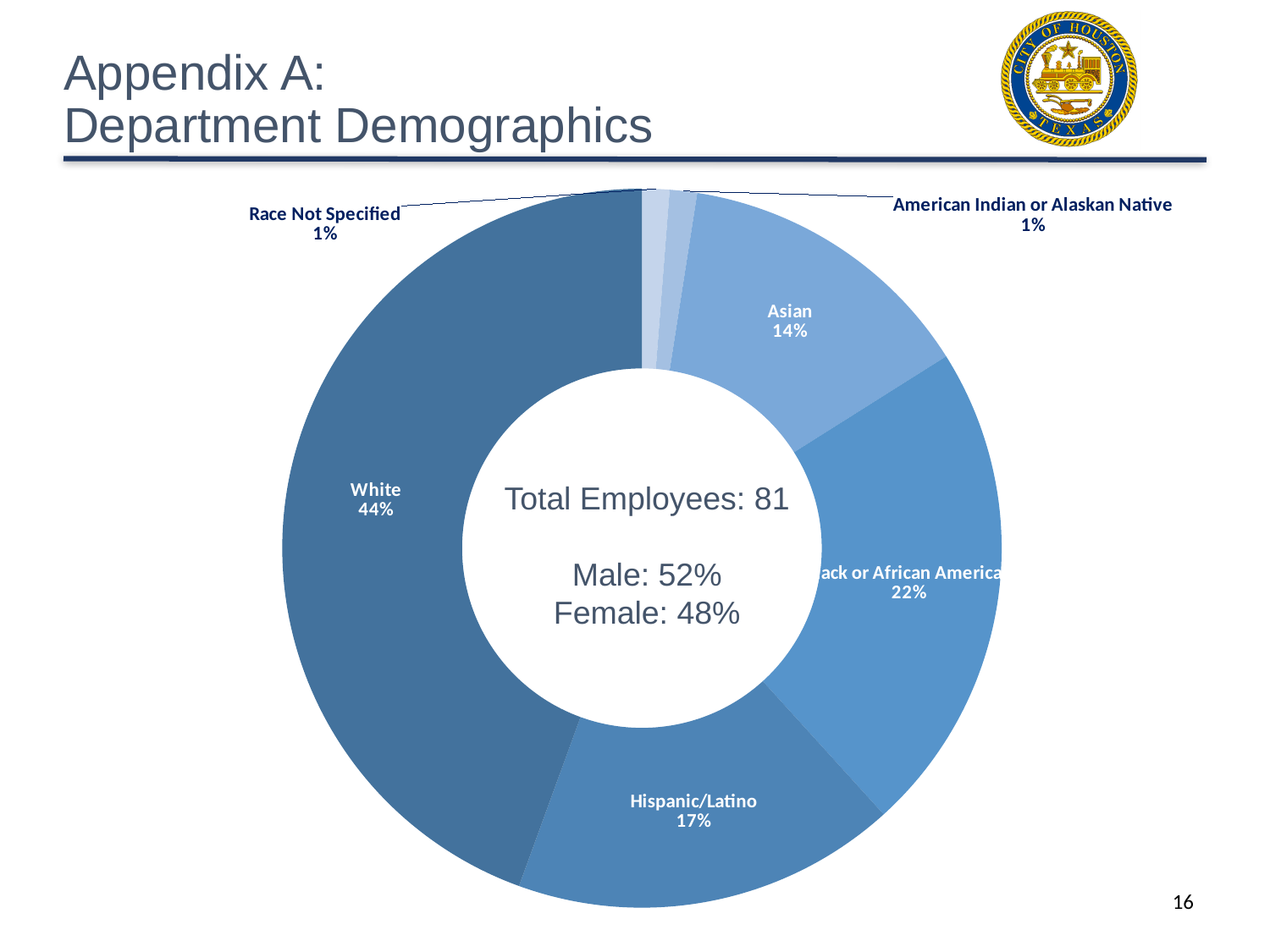
How many racial categories are shown in the chart? 6 What is the total number of employees shown in the center of the chart? 81 How many percentage points larger is the White share than the Black or African American share? 22 What percentage of the department is White? 44% What percentage of employees has race not specified? 1% What kind of chart is shown on the slide? doughnut chart What share of employees is Asian? 14% Which racial category makes up the largest share of the department? White Which is larger, the Hispanic/Latino share or the Asian share? Hispanic/Latino What percentage of employees is Hispanic/Latino? 17% What percentage of employees is Black or African American? 22% What is the difference in percentage points between the Hispanic/Latino share and the Asian share? 3